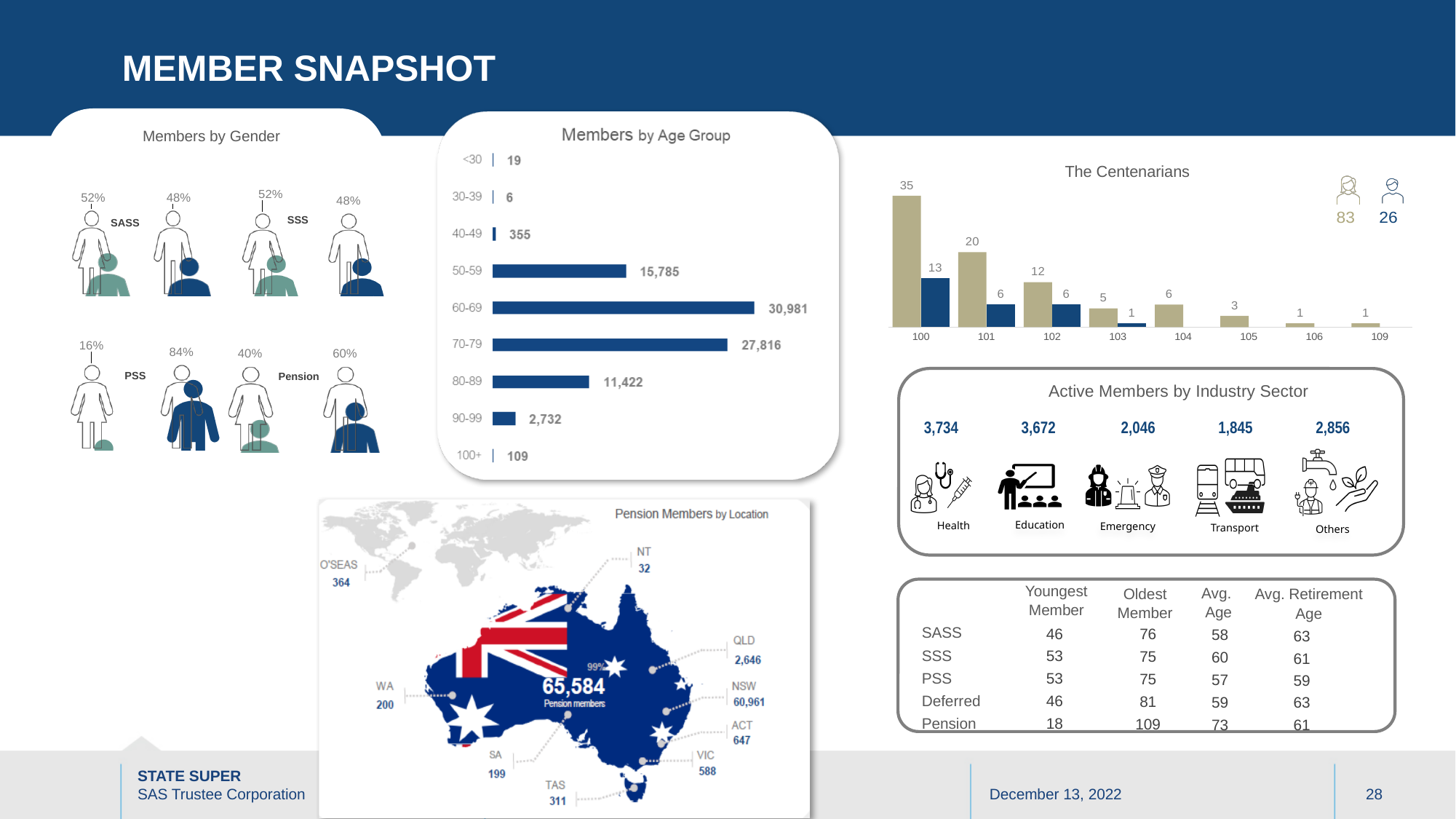
In the Members by Age Group chart, which age group has the most members? 60-69 In the Members by Age Group chart, which age group has the fewest members? 30-39 What kind of chart is the Members by Age Group chart? bar chart How many age categories are shown on the x axis of The Centenarians chart? 8 In the Members by Age Group chart, what is the difference between the 70-79 and 80-89 age groups? 16,394 How many age groups are shown in the Members by Age Group chart? 9 How many series (bar colours) are plotted in The Centenarians chart? 2 In the Members by Age Group chart, how many members are in the 60-69 age group? 30,981 In The Centenarians chart, what is the value of the tan bar at age 100? 35 In The Centenarians chart, what is the difference between the tan bar and the blue bar at age 101? 14 In The Centenarians chart, at which age is the tan bar highest? 100 In the Members by Age Group chart, which has more members, the 50-59 group or the 80-89 group? 50-59